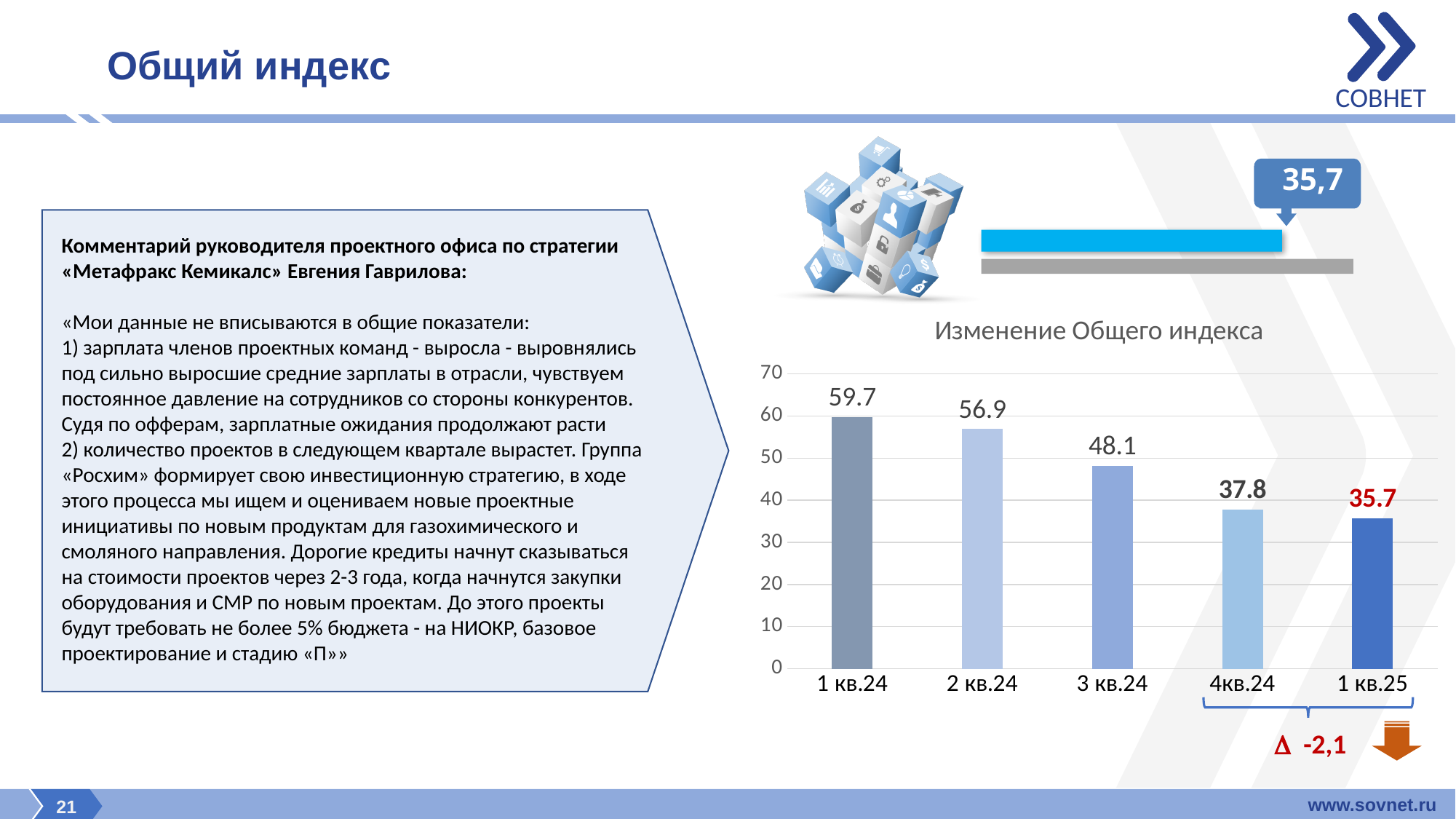
In the chart "Изменение Общего индекса", which is larger: the value for 2 кв.24 or 3 кв.24? 2 кв.24 What is the value for 1 кв.24 in the chart "Изменение Общего индекса"? 59.7 What is the value for 1 кв.25 in the chart "Изменение Общего индекса"? 35.7 What is the difference between the values for 4кв.24 and 1 кв.25 in the chart "Изменение Общего индекса"? 2.1 Do the values in the chart "Изменение Общего индекса" rise or fall from 1 кв.24 to 1 кв.25? fall What is the difference between the values for 1 кв.24 and 2 кв.24 in the chart "Изменение Общего индекса"? 2.8 What is the value for 3 кв.24 in the chart "Изменение Общего индекса"? 48.1 Is the value for 3 кв.24 in the chart "Изменение Общего индекса" greater or less than 50? less What kind of chart is "Изменение Общего индекса"? bar chart How many quarters are shown on the x axis of the chart "Изменение Общего индекса"? 5 Which quarter has the highest value in the chart "Изменение Общего индекса"? 1 кв.24 Which quarter has the lowest value in the chart "Изменение Общего индекса"? 1 кв.25